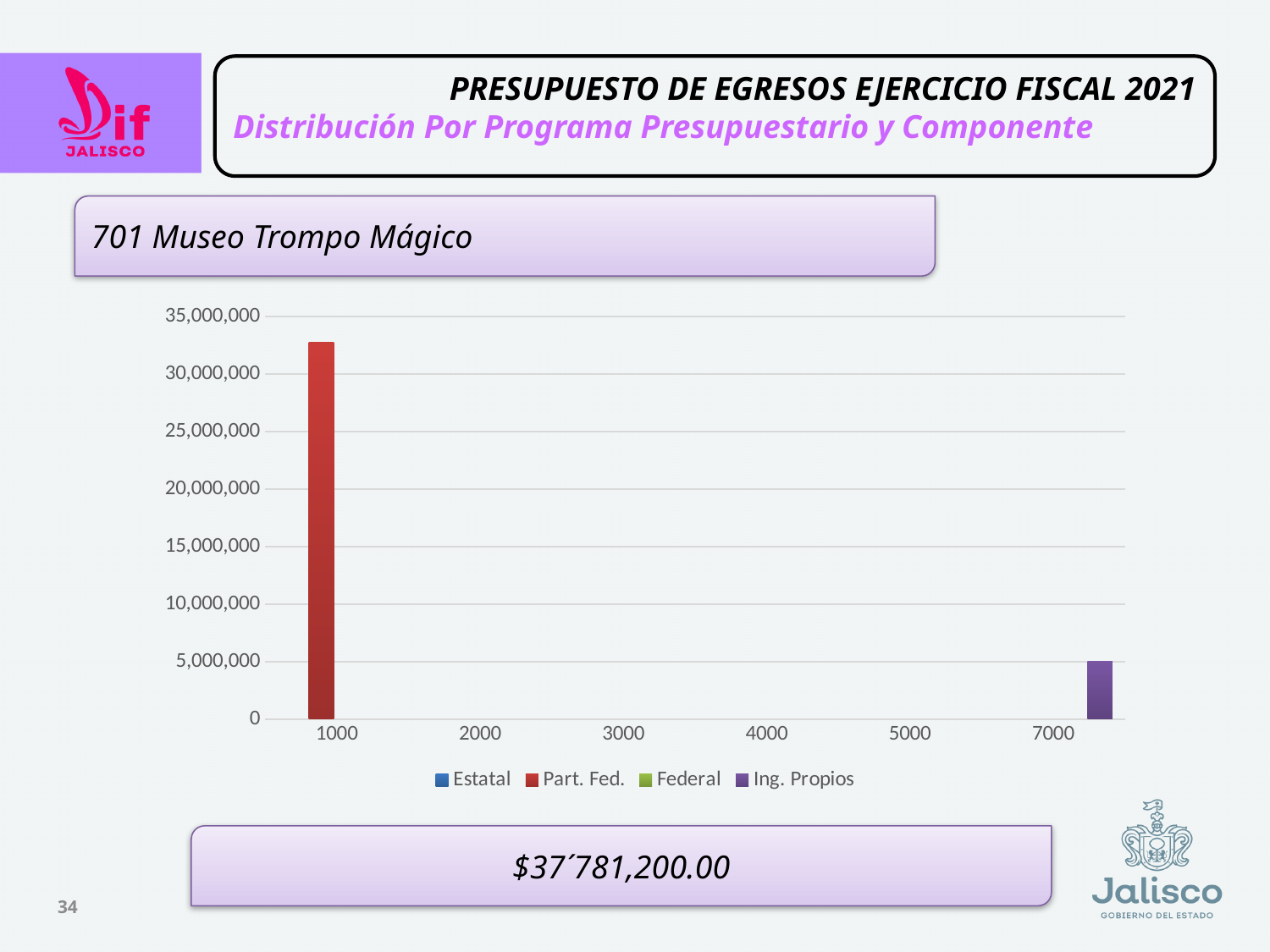
Which x-axis category has the highest bar in the chart? 1000 Which series does the tallest bar in the chart belong to? Part. Fed. Is the value of the bar at category 7000 greater or less than 10,000,000? less Is the value of the bar at category 1000 greater or less than 30,000,000? greater What kind of chart is shown on the slide? bar chart Which is larger, the bar at category 1000 or the bar at category 7000? 1000 How many series does the chart legend list? 4 What is the highest value shown on the chart's y axis? 35,000,000 What is the name of the program shown above the chart? 701 Museo Trompo Mágico How many categories are shown on the x axis of the chart? 6 Which series does the bar at category 7000 belong to? Ing. Propios